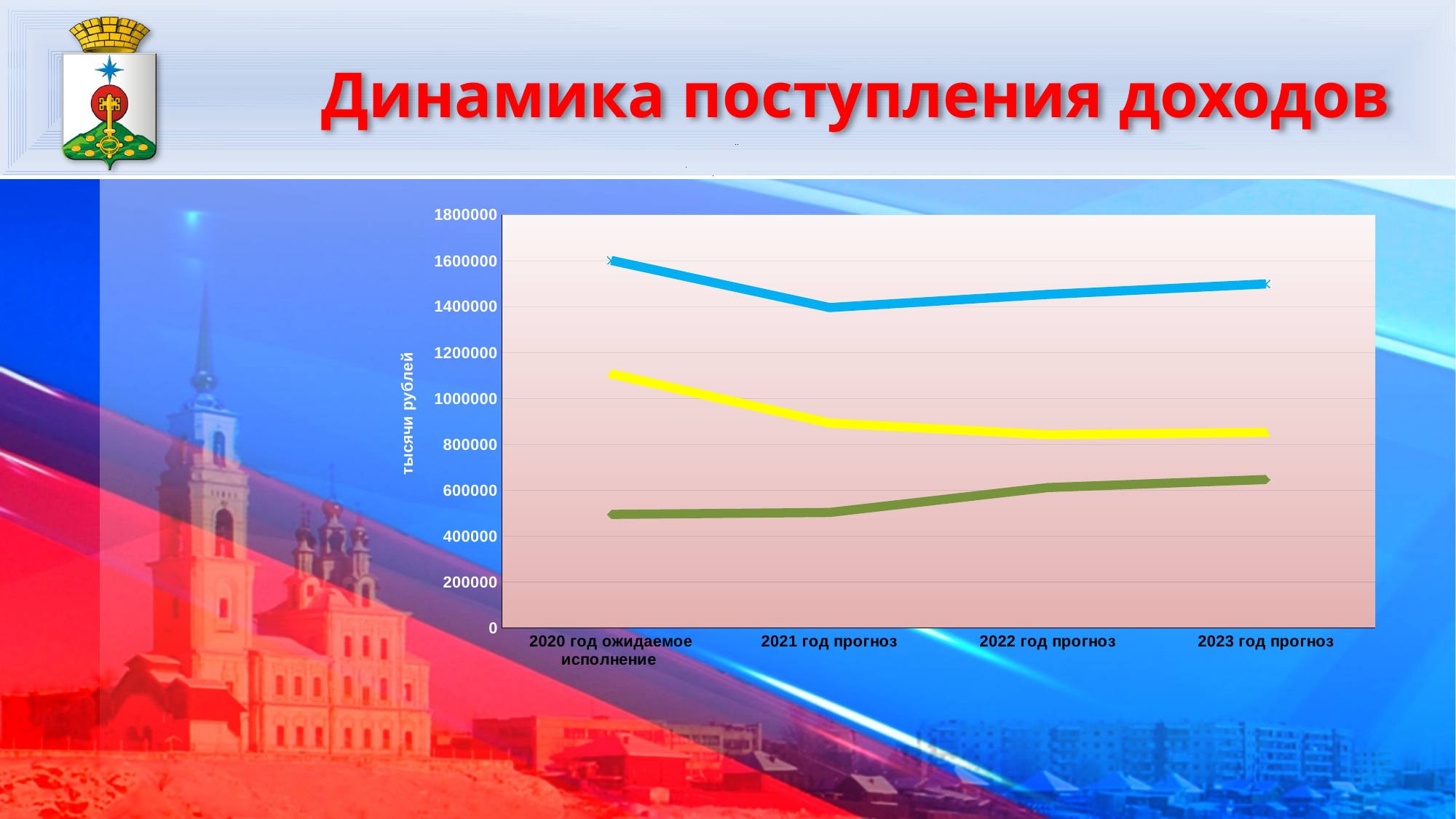
Is the value of the green line for 2023 год прогноз greater or less than 600000? greater What kind of chart is shown on the slide? line chart Is the value of the blue line for 2020 год ожидаемое исполнение greater or less than 1400000? greater Is the value of the yellow line for 2020 год ожидаемое исполнение greater or less than 1000000? greater What is the title of the chart? Динамика поступления доходов How many categories are shown along the x axis of the chart? 4 Which line has the highest values across all years: blue, yellow or green? blue Does the green line rise or fall from 2020 год ожидаемое исполнение to 2023 год прогноз? rises What is the label on the vertical axis of the chart? тысячи рублей How many lines are plotted on the chart? 3